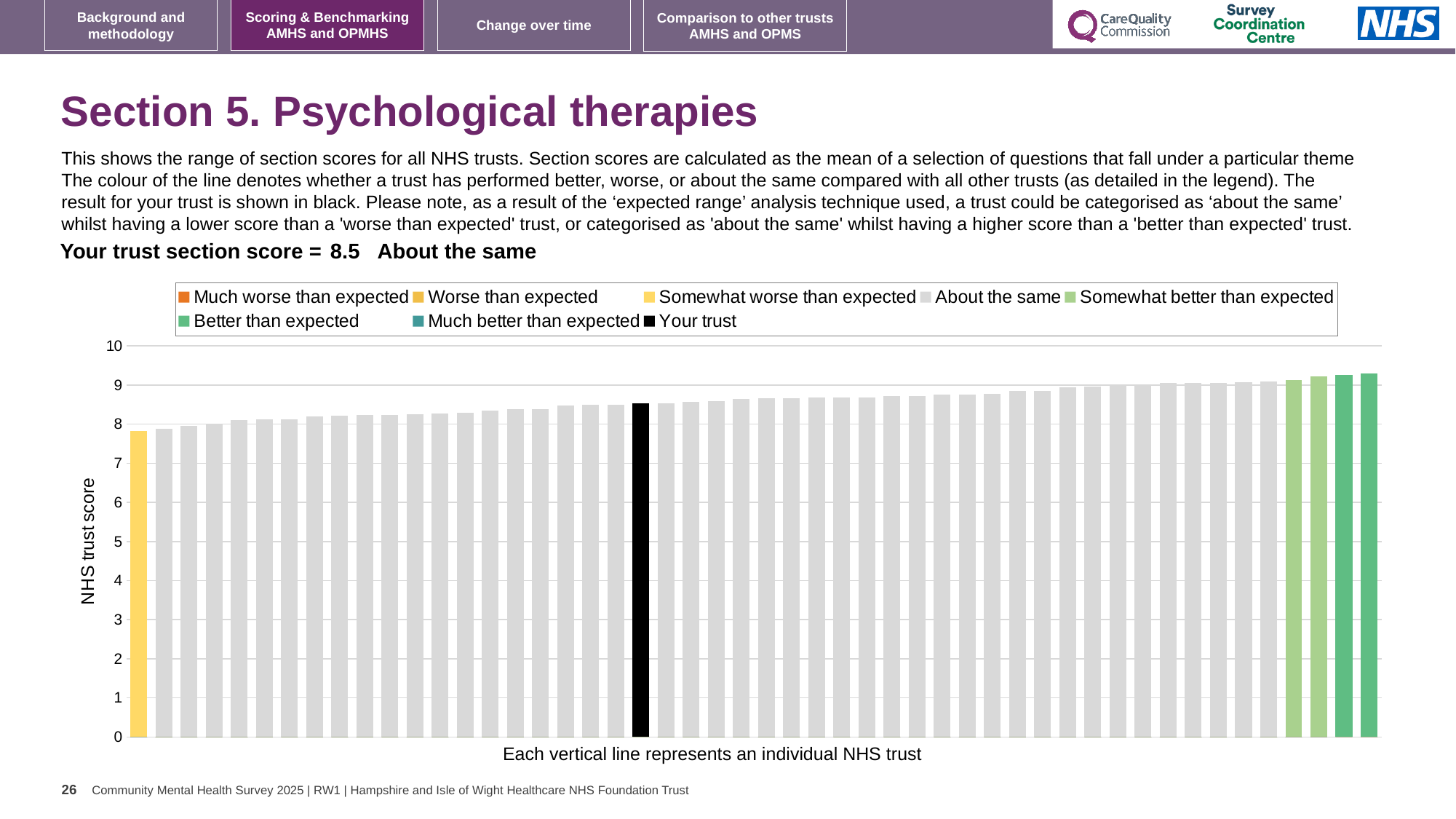
What is the title of the y axis? NHS trust score Is the value for the leftmost (yellow) bar greater or less than 9? less Which is higher, the black 'Your trust' bar or the leftmost yellow bar? the black 'Your trust' bar Is the value for the rightmost bar greater or less than 9? greater Is the value for the black 'Your trust' bar greater or less than 8? greater Which category is your trust placed in for this section? About the same How many entries does the chart legend list? 8 Do the bar values rise or fall from left to right along the x axis? rise What colour is the bar representing your trust? black What is the section score for your trust? 8.5 What kind of chart is shown on the slide? bar chart How many bars are coloured as 'Somewhat worse than expected' (yellow)? 1